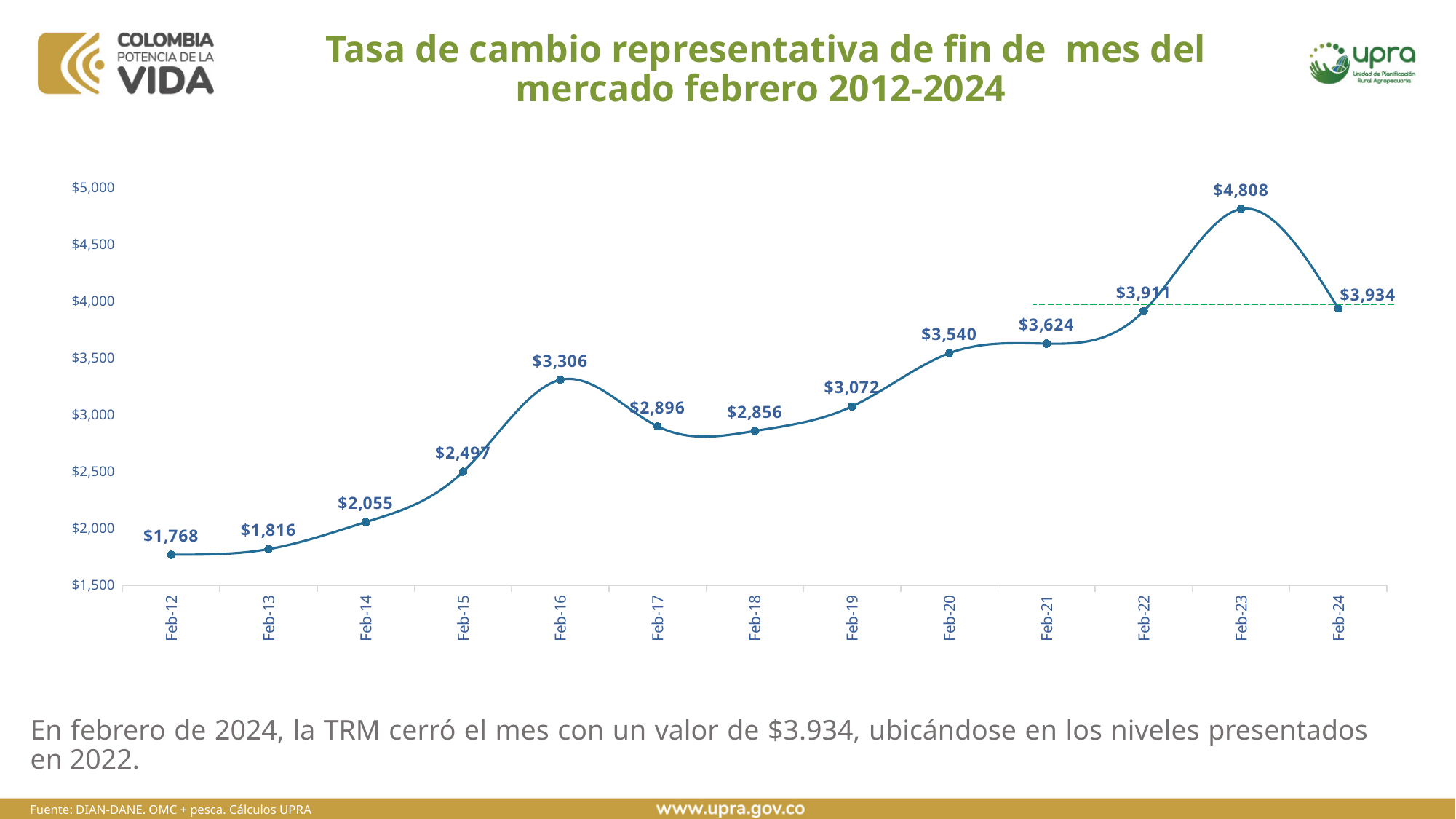
Do the values rise or fall from Feb-12 to Feb-16? rise Which is larger, the value for Feb-17 or the value for Feb-18? Feb-17 What is the value for Feb-12? $1,768 What kind of chart is shown on the slide? line chart What is the value for Feb-24? $3,934 How many data points are plotted on the chart? 13 Is the value for Feb-20 greater or less than $3,500? greater Which point has the highest value? Feb-23 What is the value for Feb-16? $3,306 What is the difference between the values for Feb-23 and Feb-24? $874 Which point has the lowest value? Feb-12 What is the title of the chart? Tasa de cambio representativa de fin de mes del mercado febrero 2012-2024